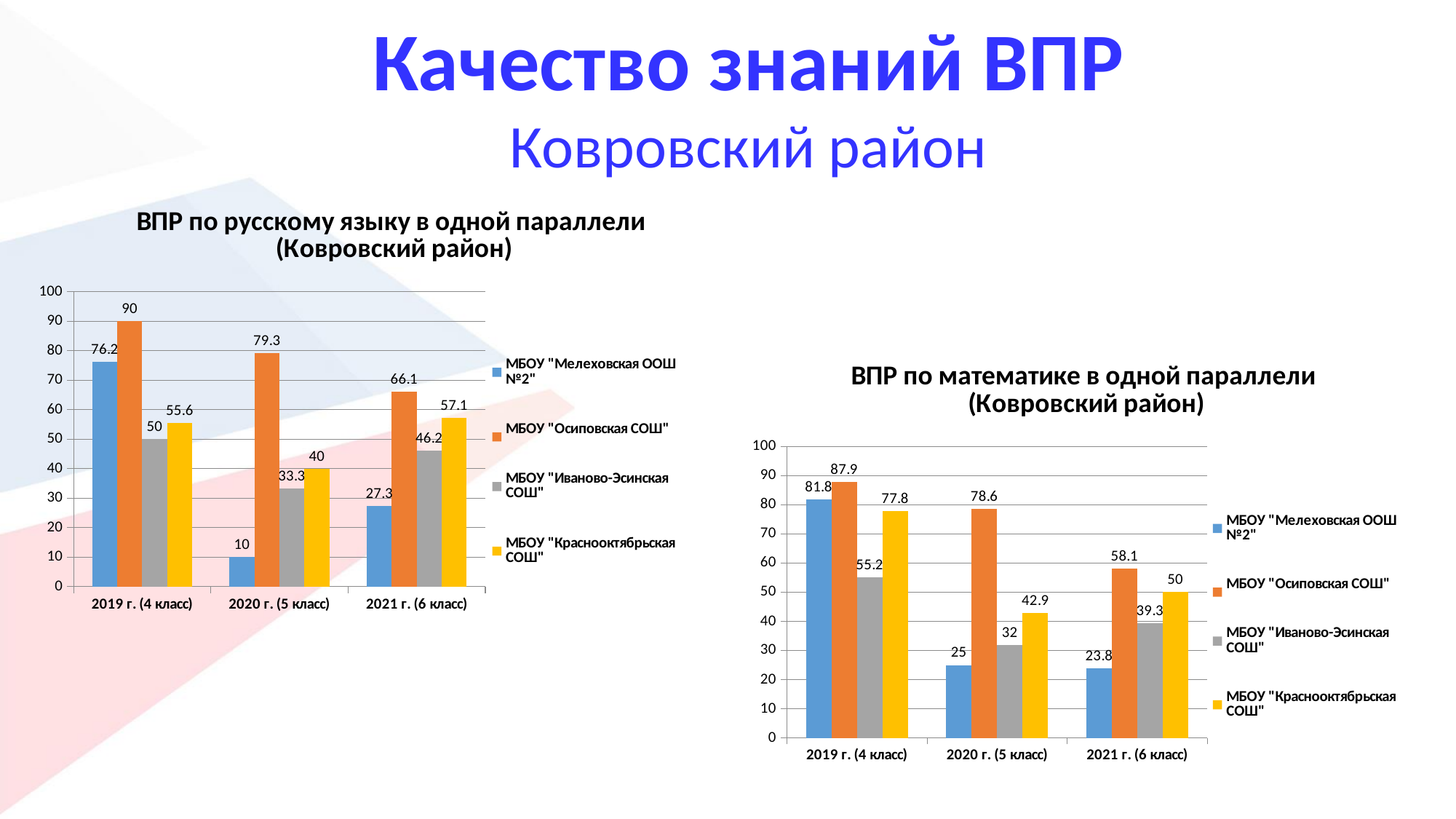
How many series does the legend list in the chart "ВПР по математике в одной параллели (Ковровский район)"? 4 In the chart "ВПР по математике в одной параллели (Ковровский район)", which school has the lowest value in 2019 г. (4 класс)? МБОУ "Иваново-Эсинская СОШ" In the chart "ВПР по русскому языку в одной параллели (Ковровский район)", what is the difference between the values for МБОУ "Осиповская СОШ" and МБОУ "Мелеховская ООШ №2" in 2020 г. (5 класс)? 69.3 How many year categories are shown on the x axis of the chart "ВПР по русскому языку в одной параллели (Ковровский район)"? 3 What kind of chart is "ВПР по математике в одной параллели (Ковровский район)"? Bar chart In the chart "ВПР по русскому языку в одной параллели (Ковровский район)", which school has the highest value in 2021 г. (6 класс)? МБОУ "Осиповская СОШ" In the chart "ВПР по математике в одной параллели (Ковровский район)", what is the value for МБОУ "Иваново-Эсинская СОШ" in 2021 г. (6 класс)? 39.3 In the chart "ВПР по русскому языку в одной параллели (Ковровский район)", what is the value for МБОУ "Осиповская СОШ" in 2019 г. (4 класс)? 90 In the chart "ВПР по математике в одной параллели (Ковровский район)", which is larger: the value for МБОУ "Краснооктябрьская СОШ" in 2019 г. (4 класс) or in 2021 г. (6 класс)? 2019 г. (4 класс) In the chart "ВПР по русскому языку в одной параллели (Ковровский район)", what is the value for МБОУ "Мелеховская ООШ №2" in 2020 г. (5 класс)? 10 In the chart "ВПР по математике в одной параллели (Ковровский район)", do the values for МБОУ "Мелеховская ООШ №2" rise or fall from 2019 г. (4 класс) to 2021 г. (6 класс)? Fall In the chart "ВПР по математике в одной параллели (Ковровский район)", what is the value for МБОУ "Краснооктябрьская СОШ" in 2020 г. (5 класс)? 42.9